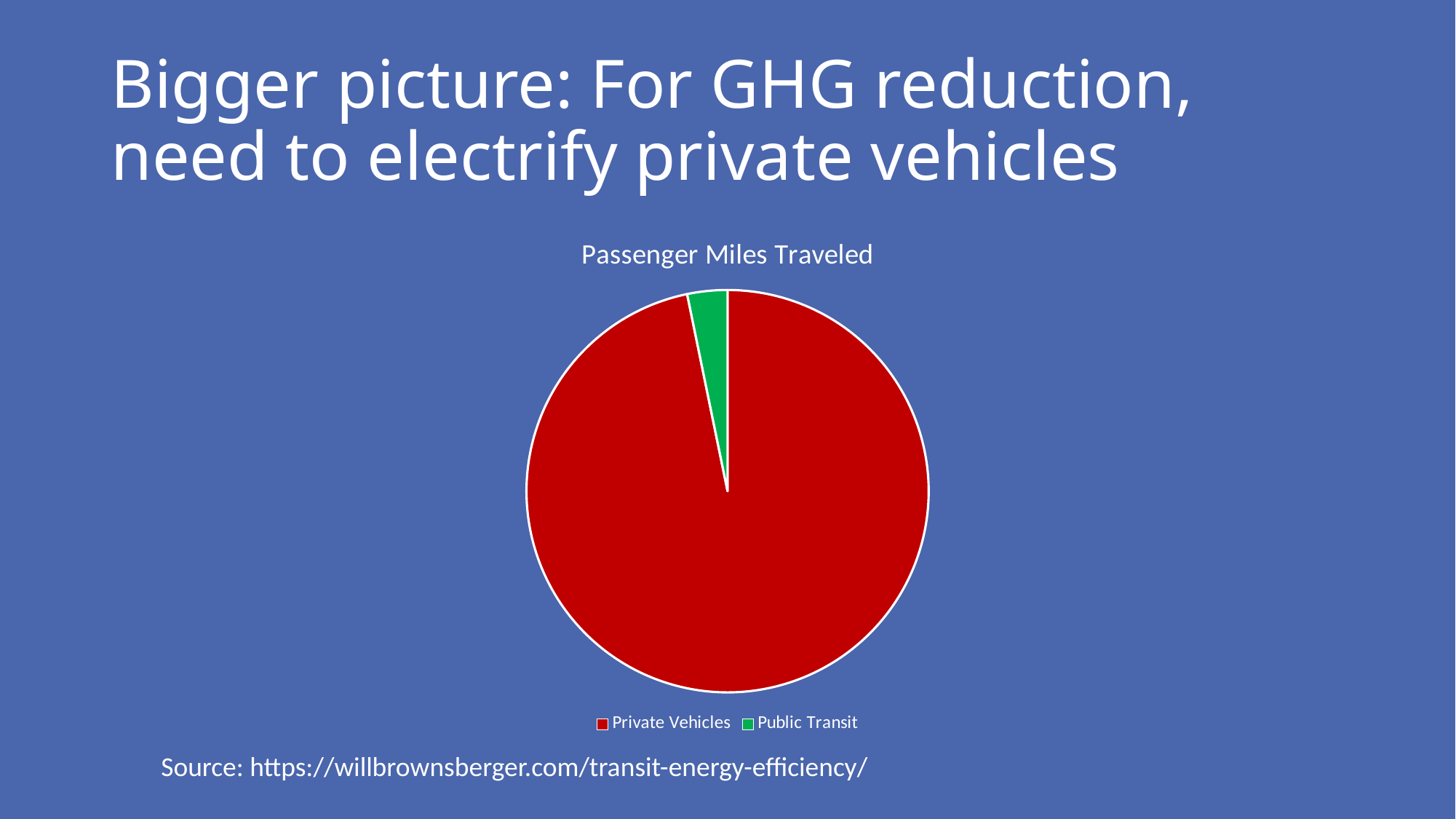
What is the title of the chart? Passenger Miles Traveled How many categories does the pie chart show? 2 What kind of chart is shown on the slide? pie chart Which categories are listed in the legend? Private Vehicles, Public Transit Which category has the smallest slice of the pie? Public Transit Which category has the largest slice of the pie? Private Vehicles Which slice is larger, Private Vehicles or Public Transit? Private Vehicles What colour is the Public Transit slice? green